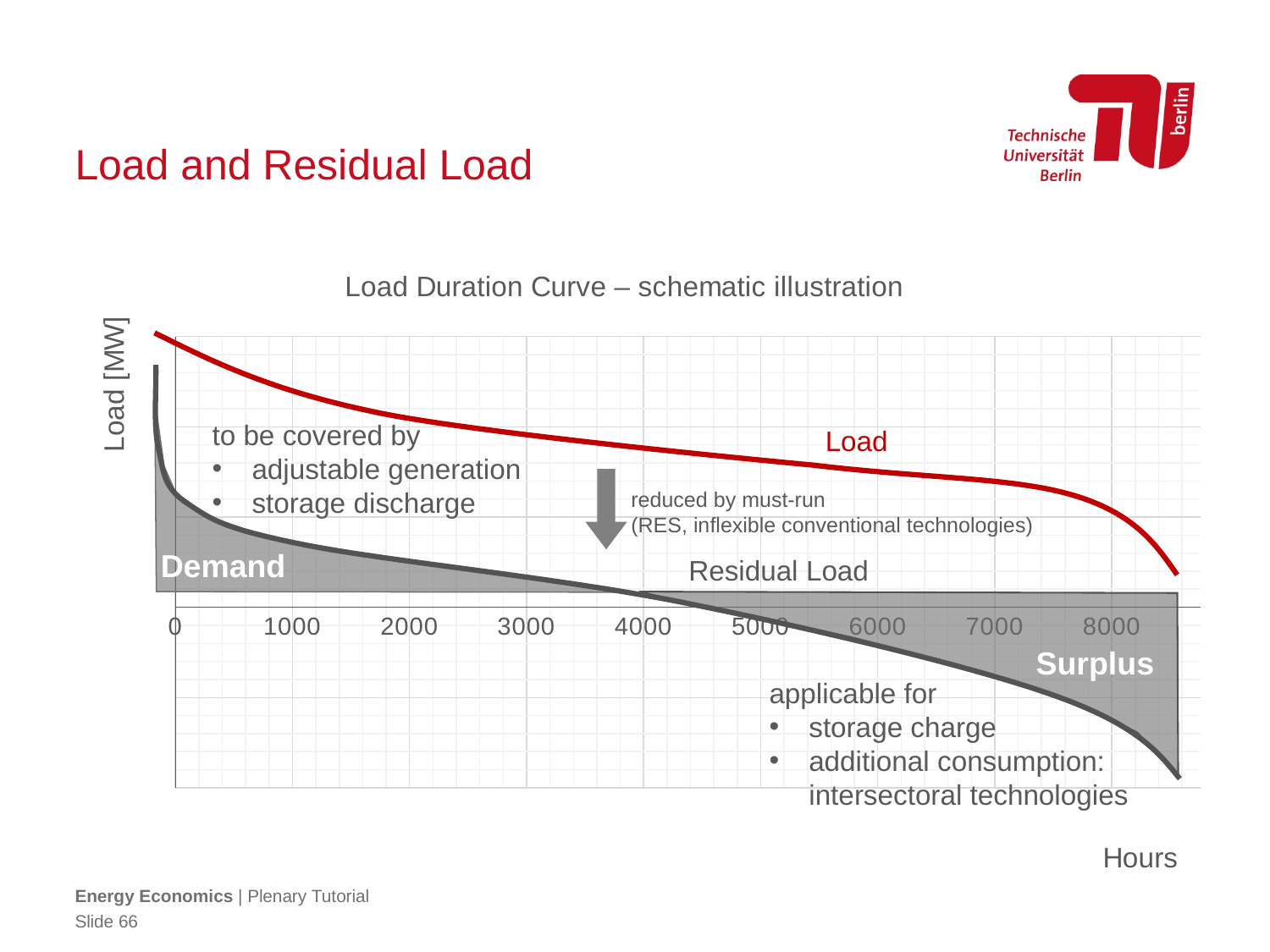
How many curves are plotted in the chart? 2 What kind of chart is shown on the slide? line chart What are the labels of the y axis and the x axis of the chart? Load [MW] and Hours Does the Residual Load curve rise or fall as hours increase along the x axis? fall Is the Residual Load at 6000 hours greater or less than 0? less What is the title of the chart? Load Duration Curve – schematic illustration Is the Residual Load at 1000 hours greater or less than 0? greater Does the Load curve rise or fall as hours increase along the x axis? fall Which curve reaches negative values, Load or Residual Load? Residual Load At which value on the x axis is the Load curve at its highest? 0 At 2000 hours, which curve is higher, Load or Residual Load? Load